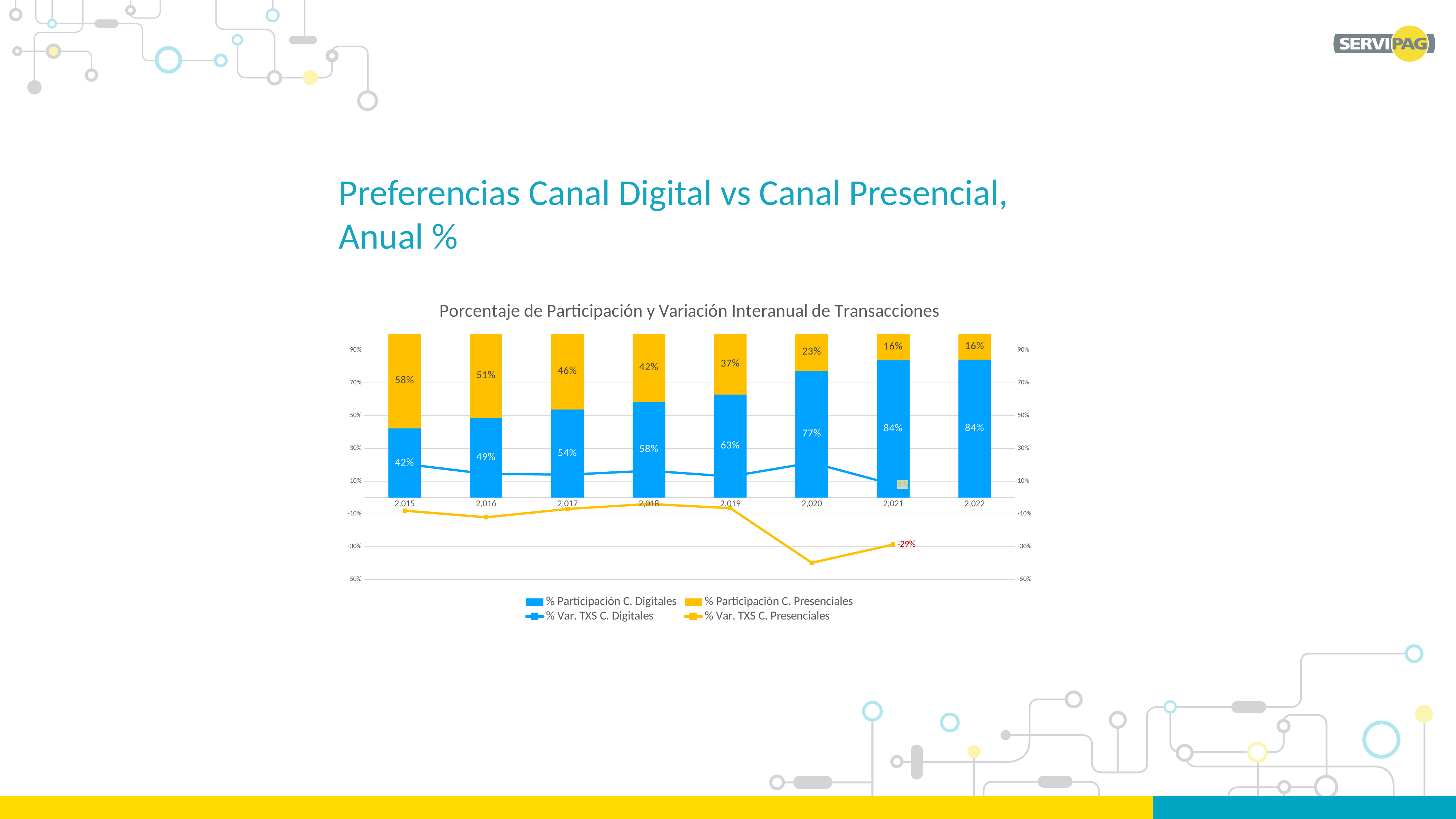
In which year is % Participación C. Digitales lowest? 2,015 Is the value of % Var. TXS C. Presenciales for 2,020 greater or less than -30%? less What kind of chart is this? A combination of a stacked bar chart and a line chart What is the value of % Participación C. Digitales for 2,015? 42% In which year is % Participación C. Presenciales highest? 2,015 How many years are shown on the x axis? 8 Does % Participación C. Digitales rise or fall from 2,015 to 2,022? rise What is the difference between % Participación C. Digitales and % Participación C. Presenciales in 2,020? 54% What is the value of % Participación C. Presenciales for 2,019? 37% How many series does the legend list? 4 In 2,017, which is larger: % Participación C. Digitales or % Participación C. Presenciales? % Participación C. Digitales